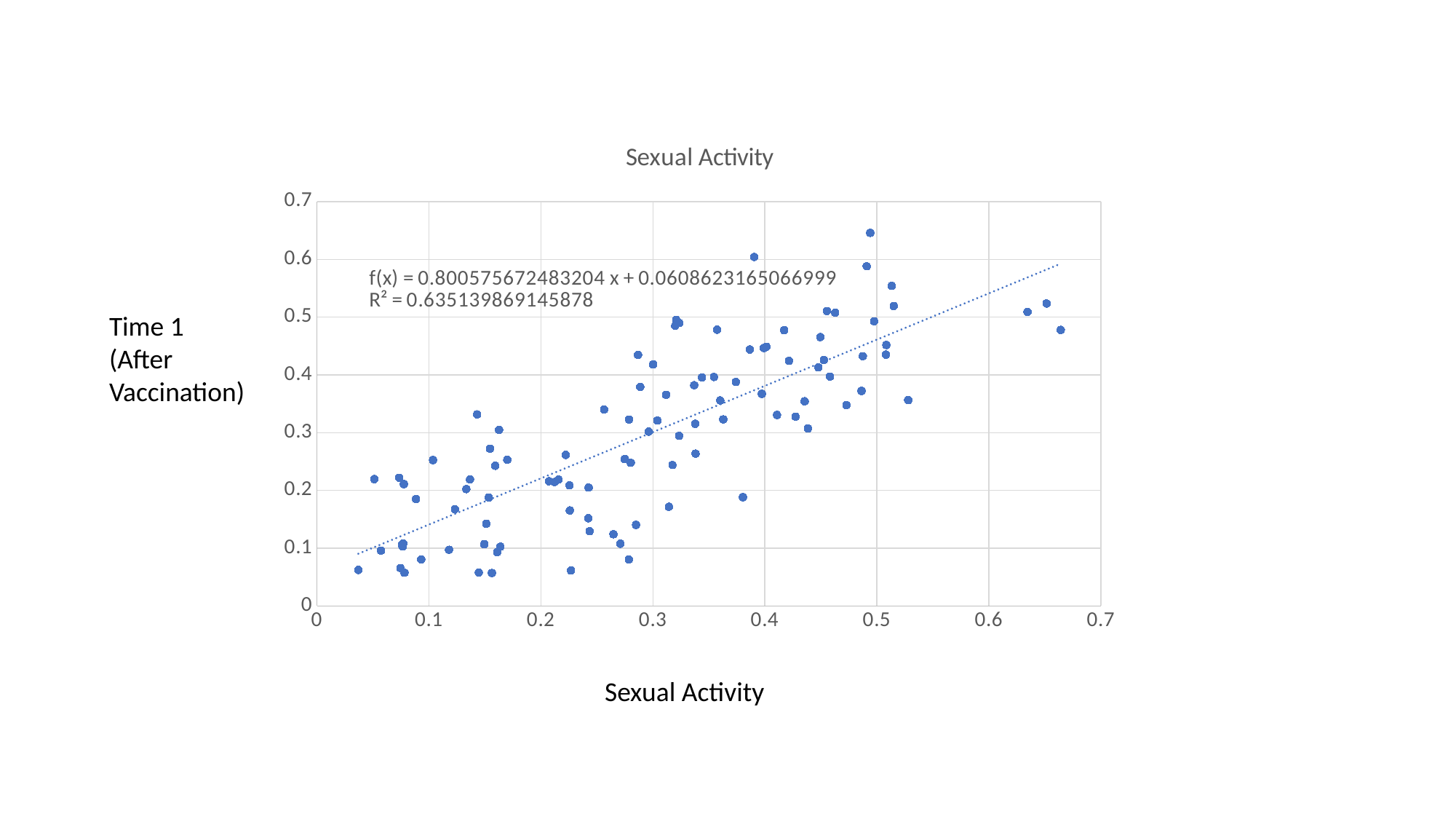
Is the y value of the highest plotted point greater or less than 0.6? greater What is the intercept of the fitted line shown in the equation on the chart? 0.0608623165066999 What R² value is printed on the chart? 0.635139869145878 Do the plotted values generally rise or fall as the x-axis value increases? rise What is the title of the chart? Sexual Activity What kind of chart is shown on the slide? scatter plot Is the y value of the leftmost plotted point (near x = 0.04) greater or less than 0.1? less Is the y value of the rightmost plotted point (near x = 0.66) greater or less than 0.4? greater What is the label of the vertical axis? Time 1 (After Vaccination) What is the highest tick value shown on the vertical axis? 0.7 What is the slope of the fitted line shown in the equation on the chart? 0.800575672483204 What is the highest tick value shown on the horizontal axis? 0.7